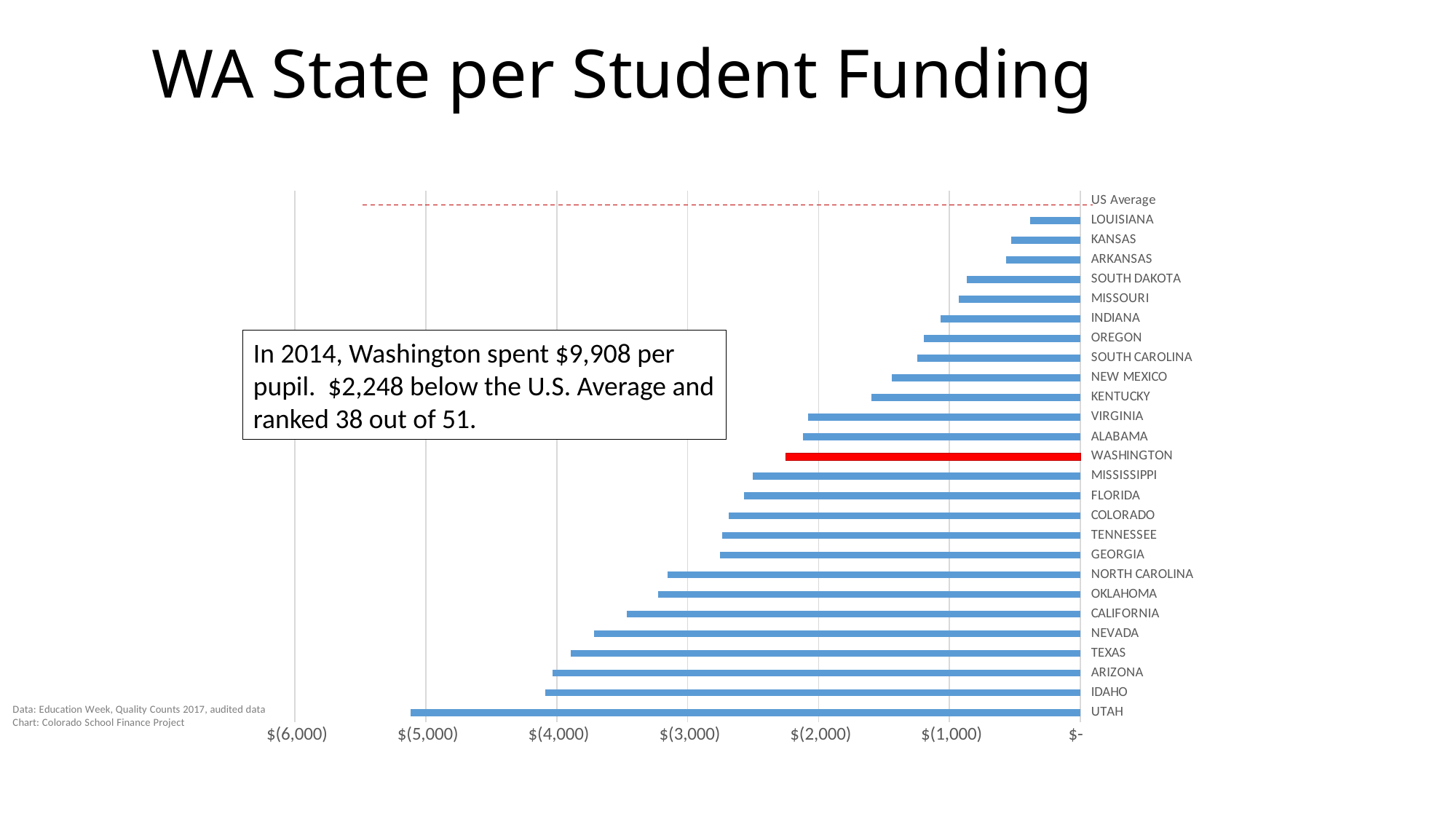
Which state has the longest bar, i.e. the largest amount below the US Average? Utah Which state has the shortest bar, i.e. the smallest amount below the US Average? Louisiana What kind of chart is shown on the slide? bar chart Is the amount below the US Average for Utah greater or less than $5,000? greater What is the title of the slide? WA State per Student Funding How many states are listed as categories in the chart? 26 Is the amount below the US Average for Louisiana greater or less than $1,000? less Is the amount below the US Average for Kentucky greater or less than $2,000? less How far below the U.S. Average was Washington's per-pupil spending, according to the slide? $2,248 Which state's bar is longer, Texas or Florida? Texas Which state's bar is drawn in red? Washington